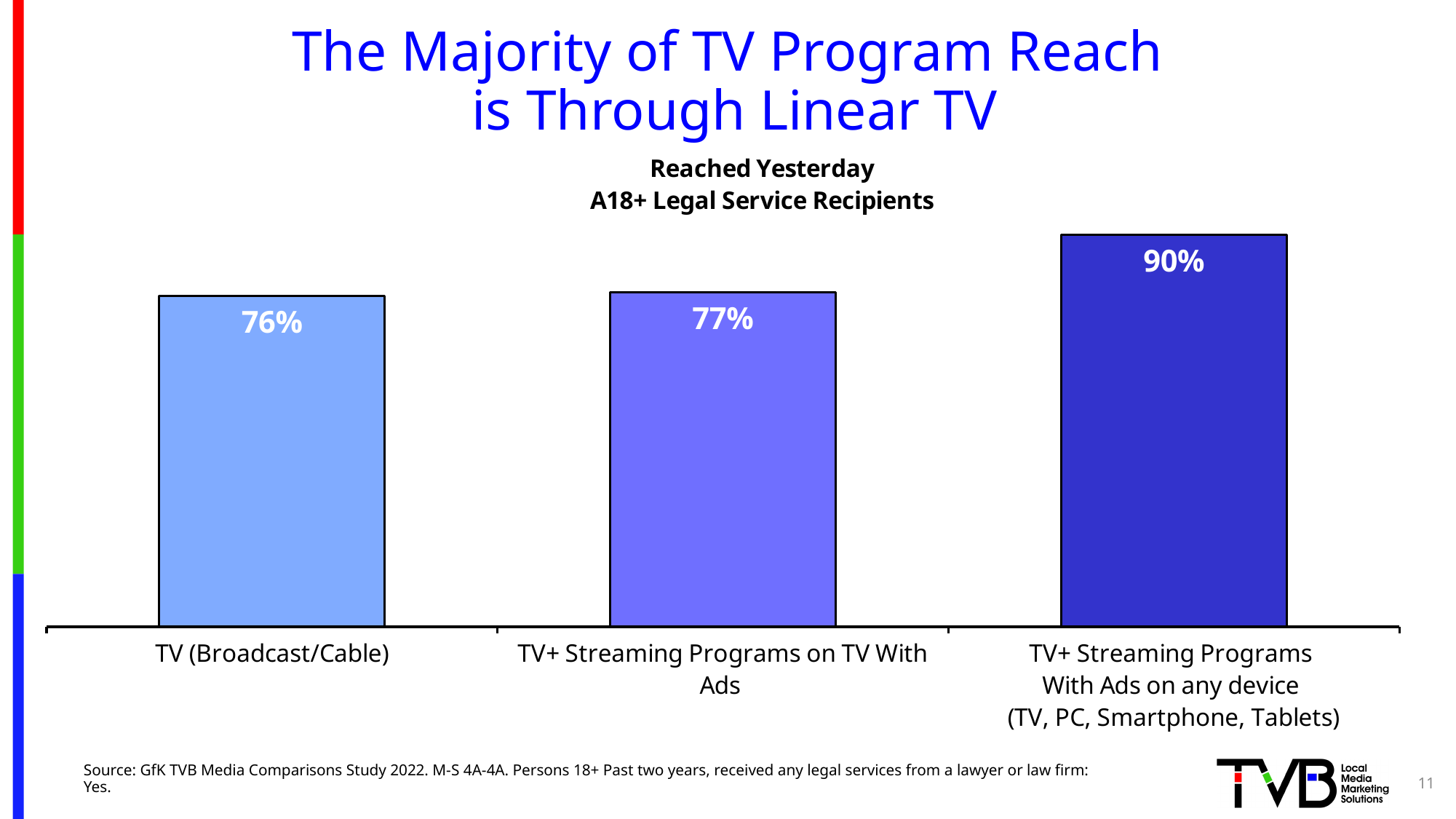
What is the title of the chart? Reached Yesterday A18+ Legal Service Recipients What is the value for TV (Broadcast/Cable)? 76% How many categories are shown in the chart? 3 What is the value for TV+ Streaming Programs With Ads on any device (TV, PC, Smartphone, Tablets)? 90% Which category has the lowest value? TV (Broadcast/Cable) What kind of chart is shown on the slide? Bar chart Which category has the highest value? TV+ Streaming Programs With Ads on any device (TV, PC, Smartphone, Tablets) Which is larger: the value for TV+ Streaming Programs With Ads on any device or the value for TV+ Streaming Programs on TV With Ads? TV+ Streaming Programs With Ads on any device What is the difference between the value for TV+ Streaming Programs on TV With Ads and the value for TV (Broadcast/Cable)? 1% What is the difference between the value for TV+ Streaming Programs With Ads on any device and the value for TV (Broadcast/Cable)? 14% Do the values rise or fall from left to right across the categories? Rise What is the value for TV+ Streaming Programs on TV With Ads? 77%